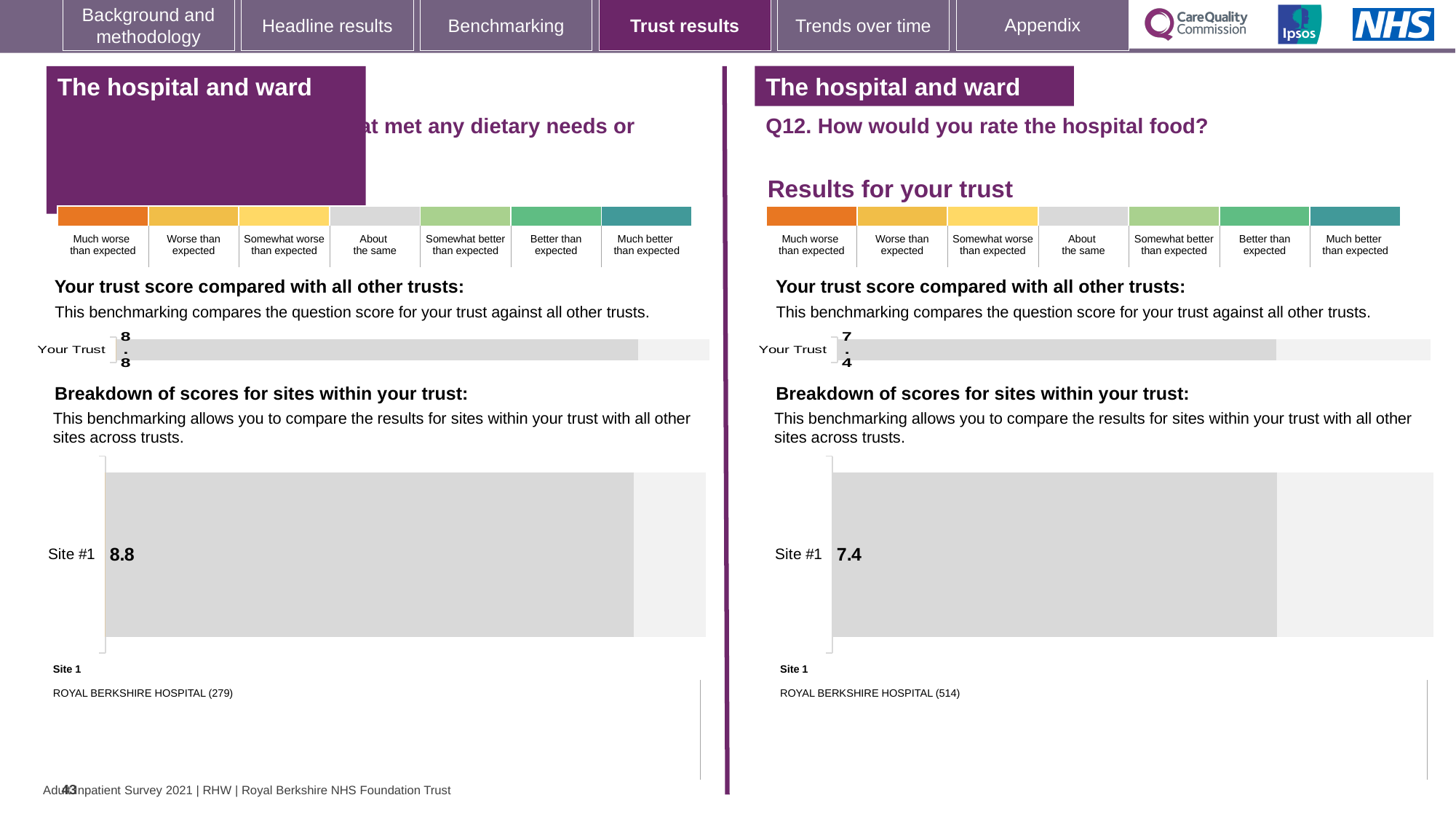
On the right-hand panel (Q12. How would you rate the hospital food?), what is the score shown for Your Trust? 7.4 What is the difference between the Site #1 score on the left-hand panel (8.8) and the Site #1 score on the right-hand panel (7.4)? 1.4 Which is larger: the Site #1 score on the left-hand panel or the Site #1 score on the right-hand panel (Q12)? Left-hand panel (8.8) On the left-hand panel, what is the score shown for Your Trust? 8.8 On the left-hand panel, what is the score shown for Site #1? 8.8 What kind of chart is used to show the Site #1 score on the right-hand panel (Q12)? Bar chart How many sites are shown in the 'Breakdown of scores for sites within your trust' chart on the left-hand panel? 1 On the right-hand panel (Q12. How would you rate the hospital food?), what is the score shown for Site #1? 7.4 How many sites are shown in the 'Breakdown of scores for sites within your trust' chart on the right-hand panel (Q12)? 1 On the left-hand panel, which site name is listed as Site 1? ROYAL BERKSHIRE HOSPITAL (279) On the right-hand panel, which site name is listed as Site 1? ROYAL BERKSHIRE HOSPITAL (514)